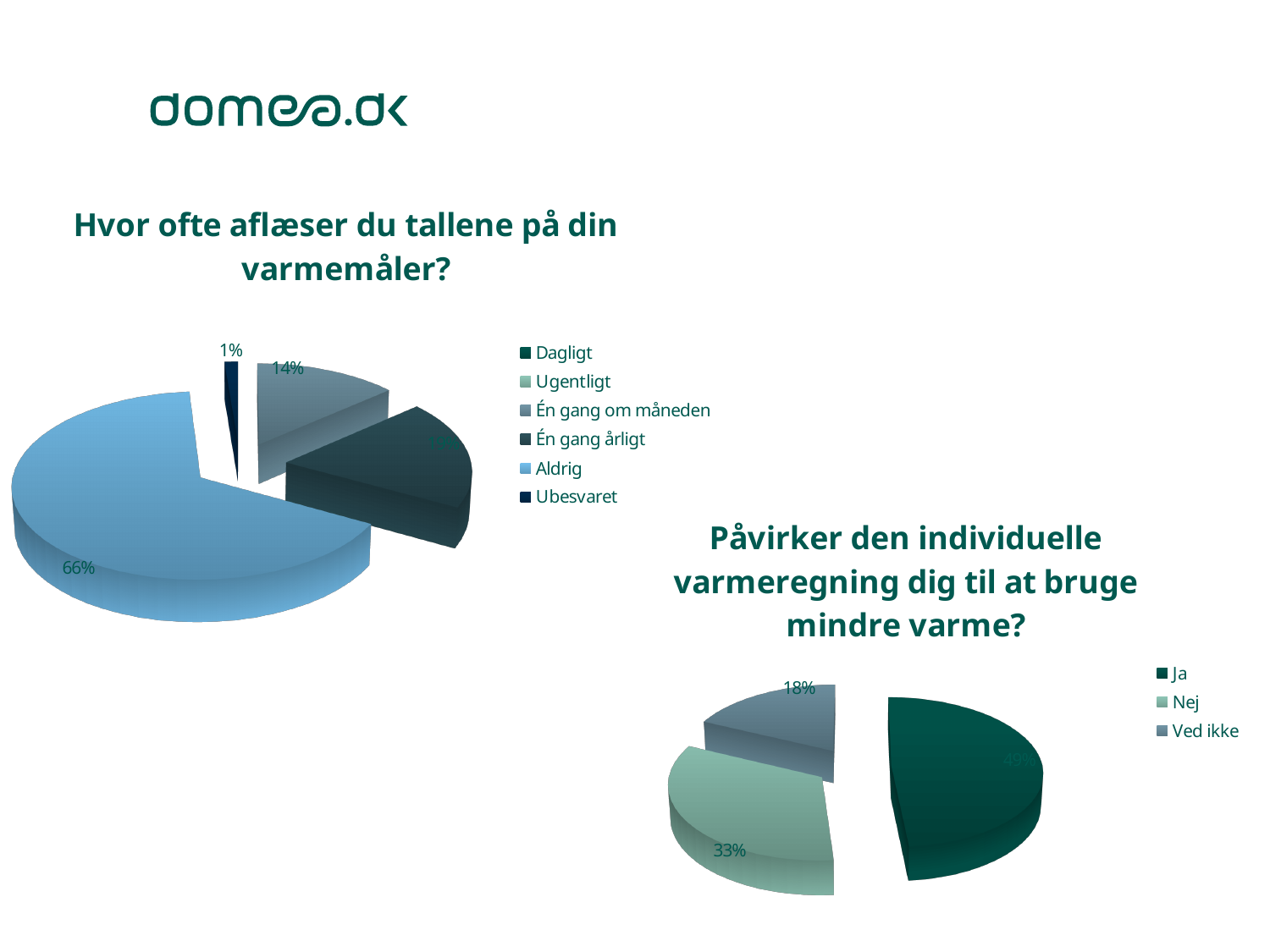
What kind of chart is the chart titled "Hvor ofte aflæser du tallene på din varmemåler?"? Pie chart In the chart "Hvor ofte aflæser du tallene på din varmemåler?", what share is labelled for Ubesvaret? 1% In the chart "Påvirker den individuelle varmeregning dig til at bruge mindre varme?", which category has the largest slice? Ja In the chart "Påvirker den individuelle varmeregning dig til at bruge mindre varme?", what share is labelled for Ved ikke? 18% How many entries does the legend of the chart "Påvirker den individuelle varmeregning dig til at bruge mindre varme?" list? 3 In the chart "Hvor ofte aflæser du tallene på din varmemåler?", which category has the largest slice? Aldrig In the chart "Påvirker den individuelle varmeregning dig til at bruge mindre varme?", which is larger, Nej or Ved ikke? Nej In the chart "Påvirker den individuelle varmeregning dig til at bruge mindre varme?", what share is labelled for Nej? 33% In the chart "Hvor ofte aflæser du tallene på din varmemåler?", what share is labelled for Aldrig? 66% How many entries does the legend of the chart "Hvor ofte aflæser du tallene på din varmemåler?" list? 6 In the chart "Hvor ofte aflæser du tallene på din varmemåler?", what share is labelled for Én gang om måneden? 14% In the chart "Hvor ofte aflæser du tallene på din varmemåler?", how many percentage points larger is Aldrig than Én gang om måneden? 52 percentage points